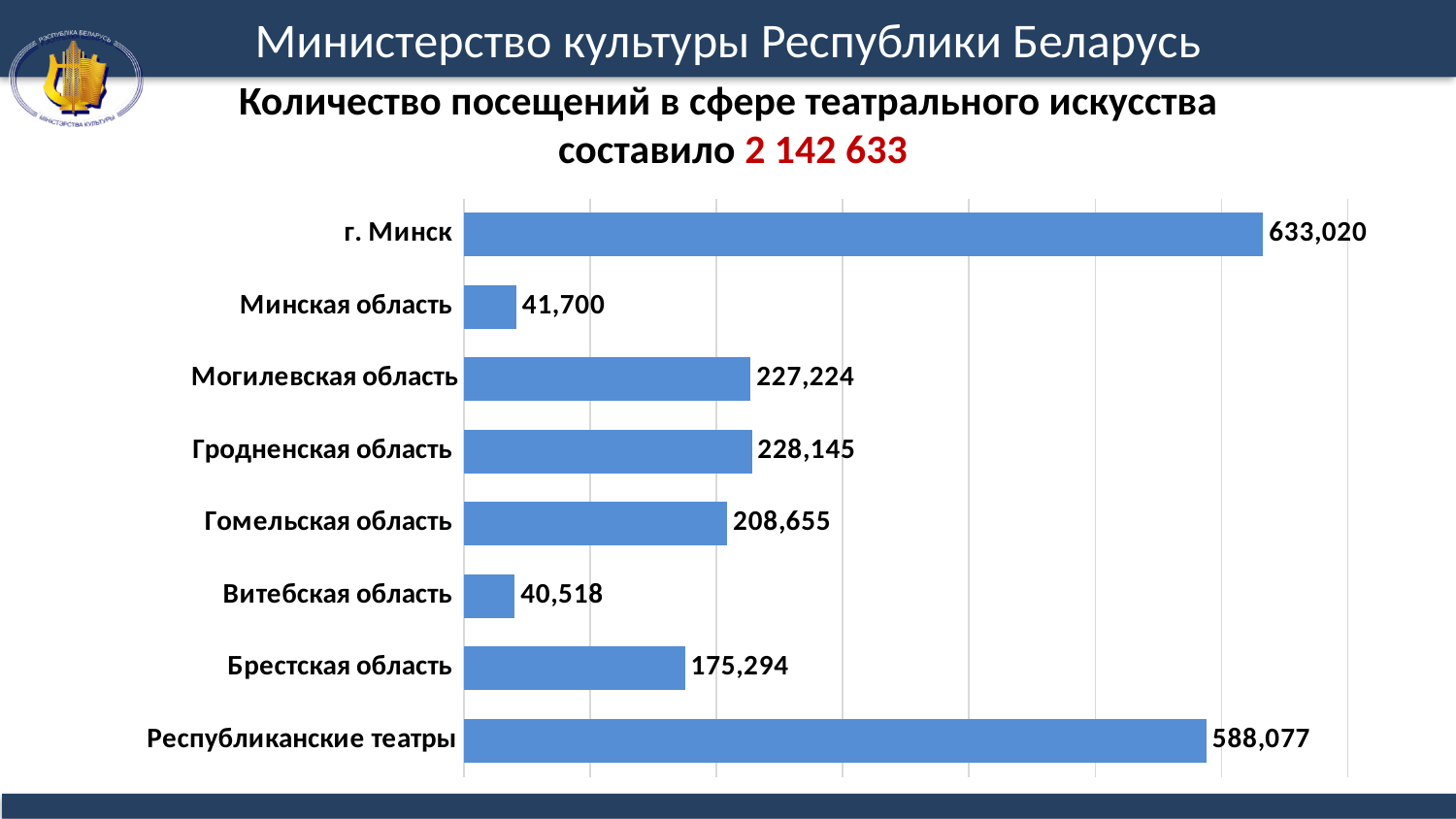
What is the value for г. Минск? 633,020 Which category has the highest value? г. Минск Which category has the lowest value? Витебская область What is the value for Республиканские театры? 588,077 Which is larger, the value for Гродненская область or Могилевская область? Гродненская область What kind of chart is shown on the slide? Bar chart According to the slide title, what was the total number of visits in the field of theatrical art? 2 142 633 How many categories are shown in the chart? 8 What is the value for Витебская область? 40,518 What is the value for Брестская область? 175,294 What is the difference between the values for Гомельская область and Брестская область? 33,361 What is the difference between the values for г. Минск and Республиканские театры? 44,943